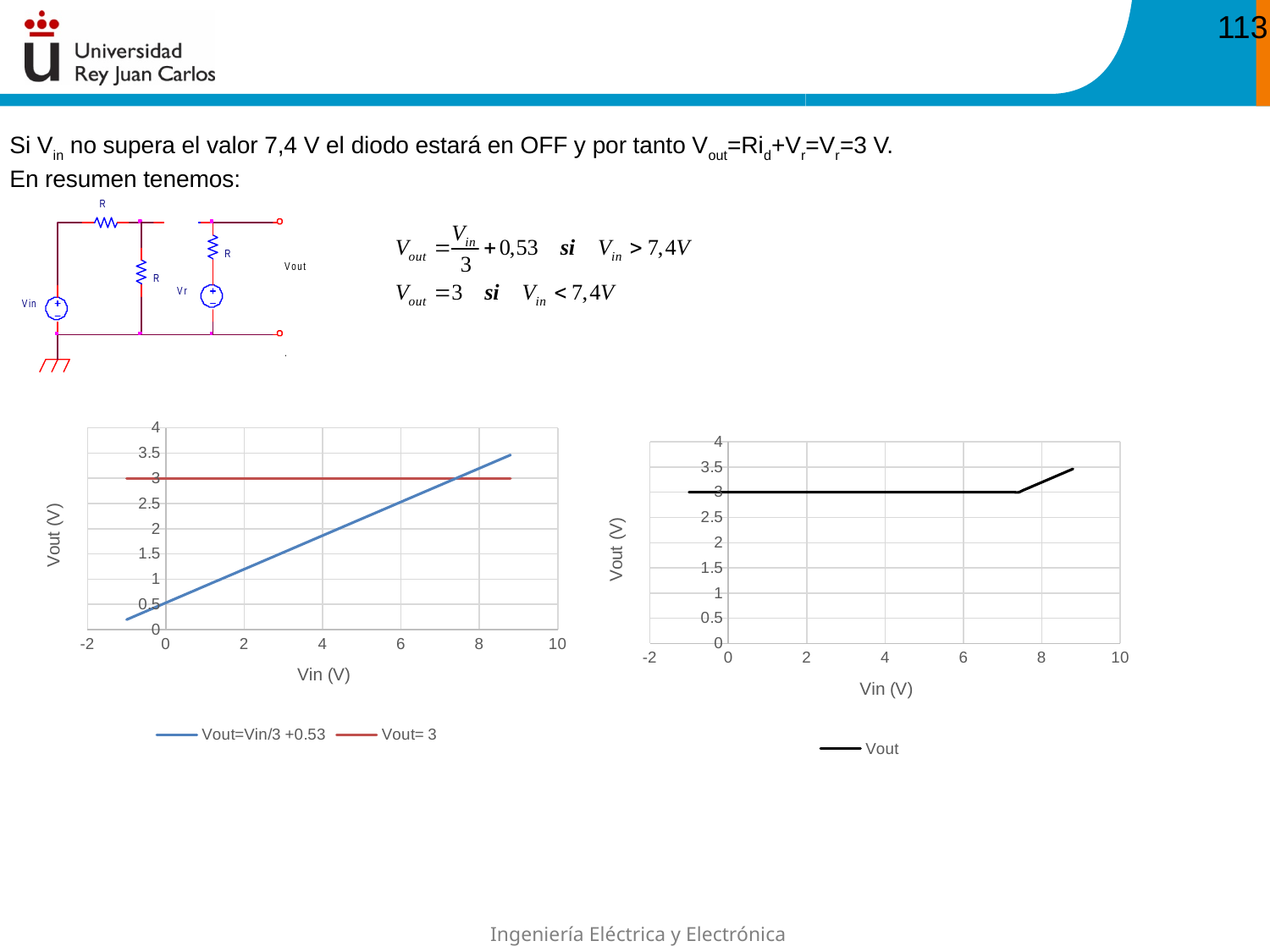
In the right chart, does the Vout line rise, fall or stay flat between Vin = 0 and Vin = 6? stay flat In the left chart, at Vin = 2, which series has the larger value, Vout=Vin/3 +0.53 or Vout= 3? Vout= 3 In the left chart, is the value of Vout=Vin/3 +0.53 at Vin = 2 greater or less than 1? greater In the left chart, is the value of Vout=Vin/3 +0.53 at Vin = 6 greater or less than 2? greater How many series does the legend of the right chart list? 1 What kind of chart is the left chart on the slide? line chart What is the x-axis title of the right chart? Vin (V) How many series does the legend of the left chart list? 2 In the left chart, does the series Vout=Vin/3 +0.53 rise or fall as Vin increases? rise In the right chart, is the value of Vout at Vin = 2 greater or less than 2.5? greater What kind of chart is the right chart on the slide? line chart In the left chart, what are the two legend entries? Vout=Vin/3 +0.53 and Vout= 3